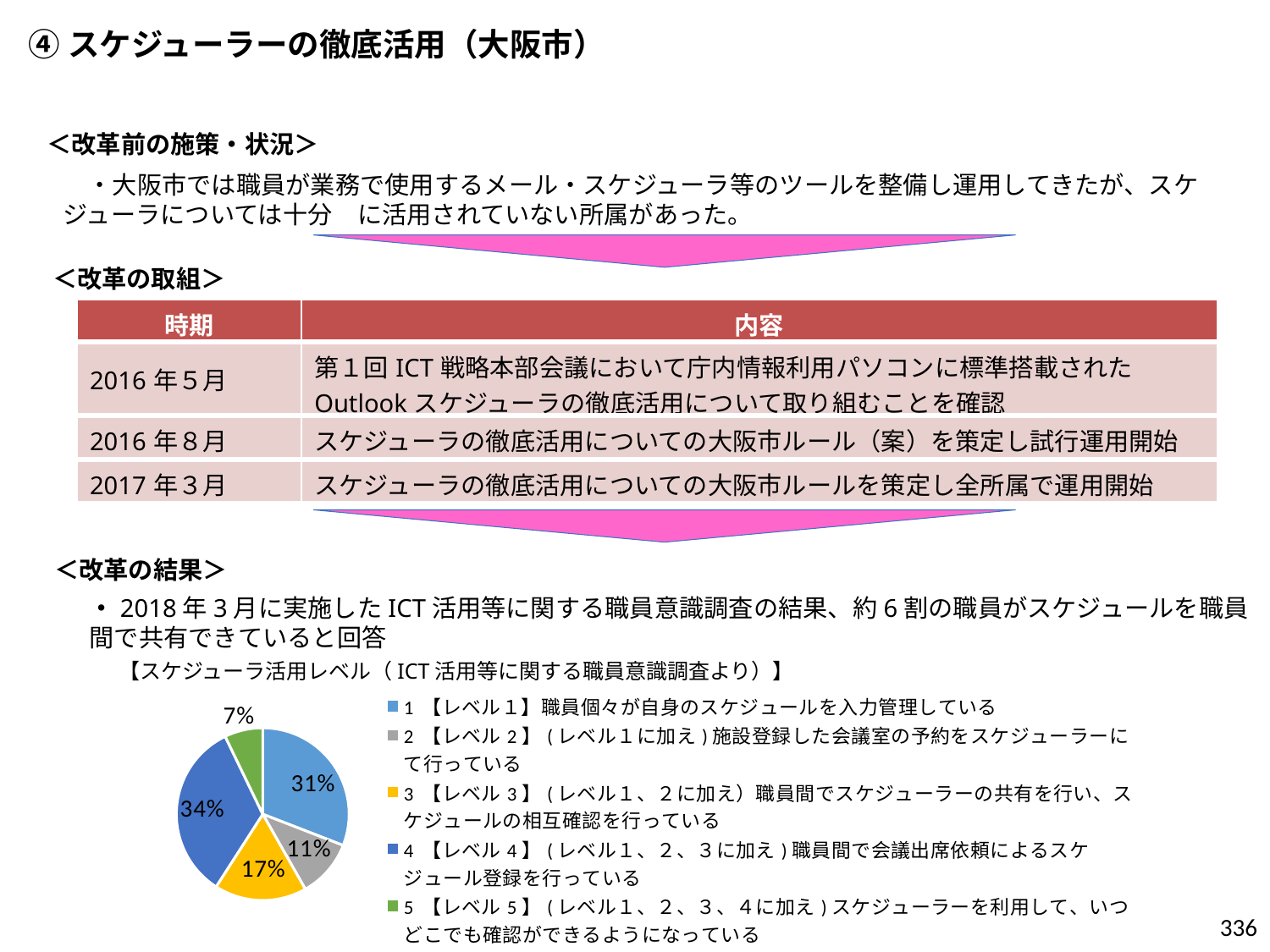
円グラフにはいくつの区分（スライス）がありますか？ 5 円グラフで最も割合が大きいのはどのレベルですか？ 4 【レベル4】 円グラフで最も割合が小さいのはどのレベルですか？ 5 【レベル5】 円グラフで「3 【レベル3】」の割合はいくつですか？ 17% 円グラフで「4 【レベル4】」のスライスは何色ですか？ 濃い青 円グラフで「4 【レベル4】」と「1 【レベル1】」の割合の差はいくつですか？ 3% 円グラフで「5 【レベル5】」の割合はいくつですか？ 7% 円グラフで「4 【レベル4】」の割合はいくつですか？ 34% このスライドのグラフはどの種類のグラフですか？ 円グラフ 円グラフで「1 【レベル1】」の割合はいくつですか？ 31% 円グラフで「2 【レベル2】」の割合はいくつですか？ 11% 円グラフで「3 【レベル3】」と「2 【レベル2】」ではどちらの割合が大きいですか？ 3 【レベル3】